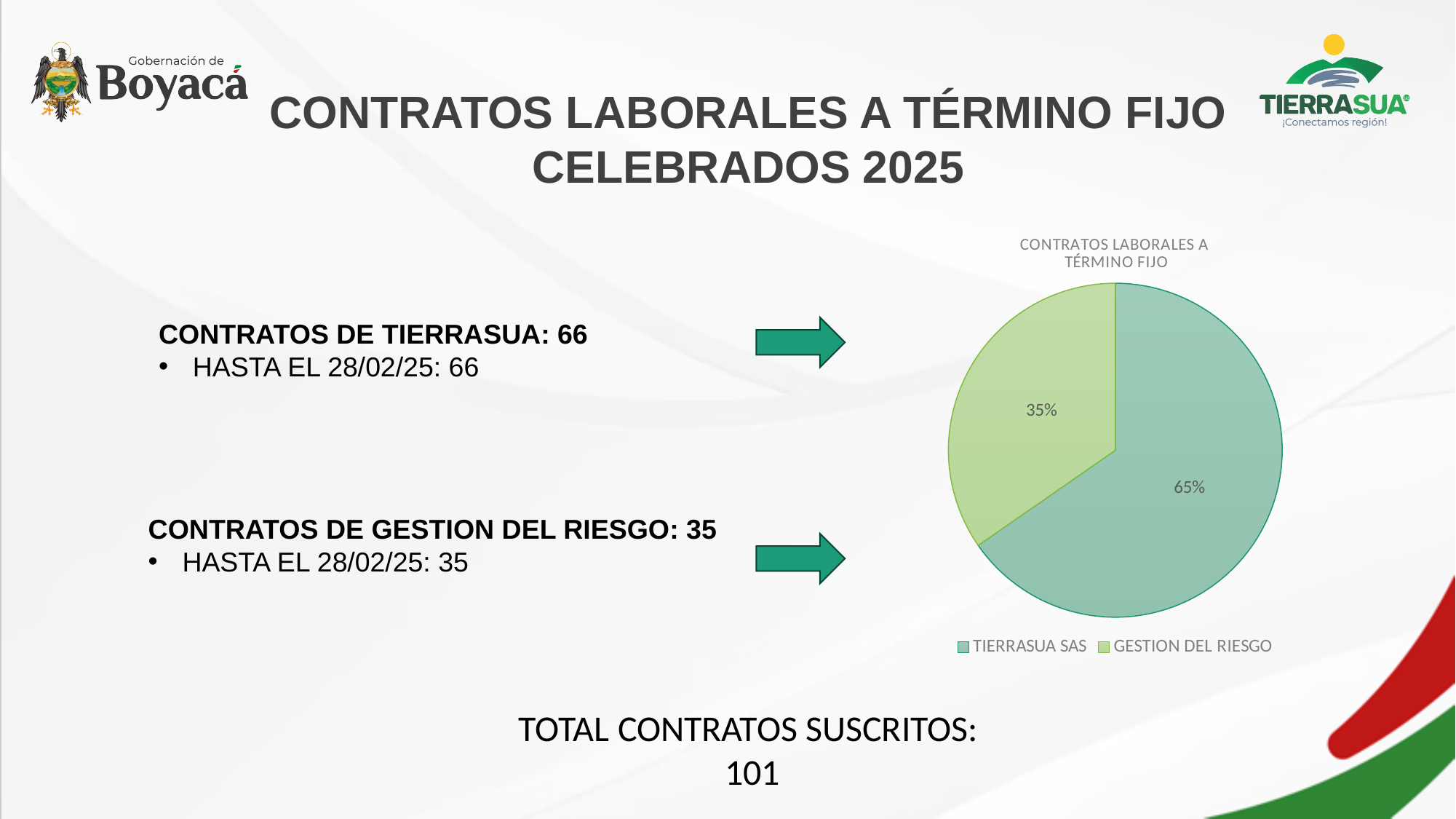
Which slice of the pie is the smallest? GESTION DEL RIESGO What share of the pie does TIERRASUA SAS represent? 65% Which slice of the pie is the largest? TIERRASUA SAS What is the title of the chart? CONTRATOS LABORALES A TÉRMINO FIJO What kind of chart is shown on the slide? Pie chart What share of the pie does GESTION DEL RIESGO represent? 35% What is the difference in percentage points between the TIERRASUA SAS slice and the GESTION DEL RIESGO slice? 30 percentage points Is the share for GESTION DEL RIESGO greater or less than 50%? less Which legend entry is shown in the lighter green colour? GESTION DEL RIESGO How many slices does the pie chart have? 2 Which is larger, the TIERRASUA SAS slice or the GESTION DEL RIESGO slice? TIERRASUA SAS How many entries does the chart legend list? 2